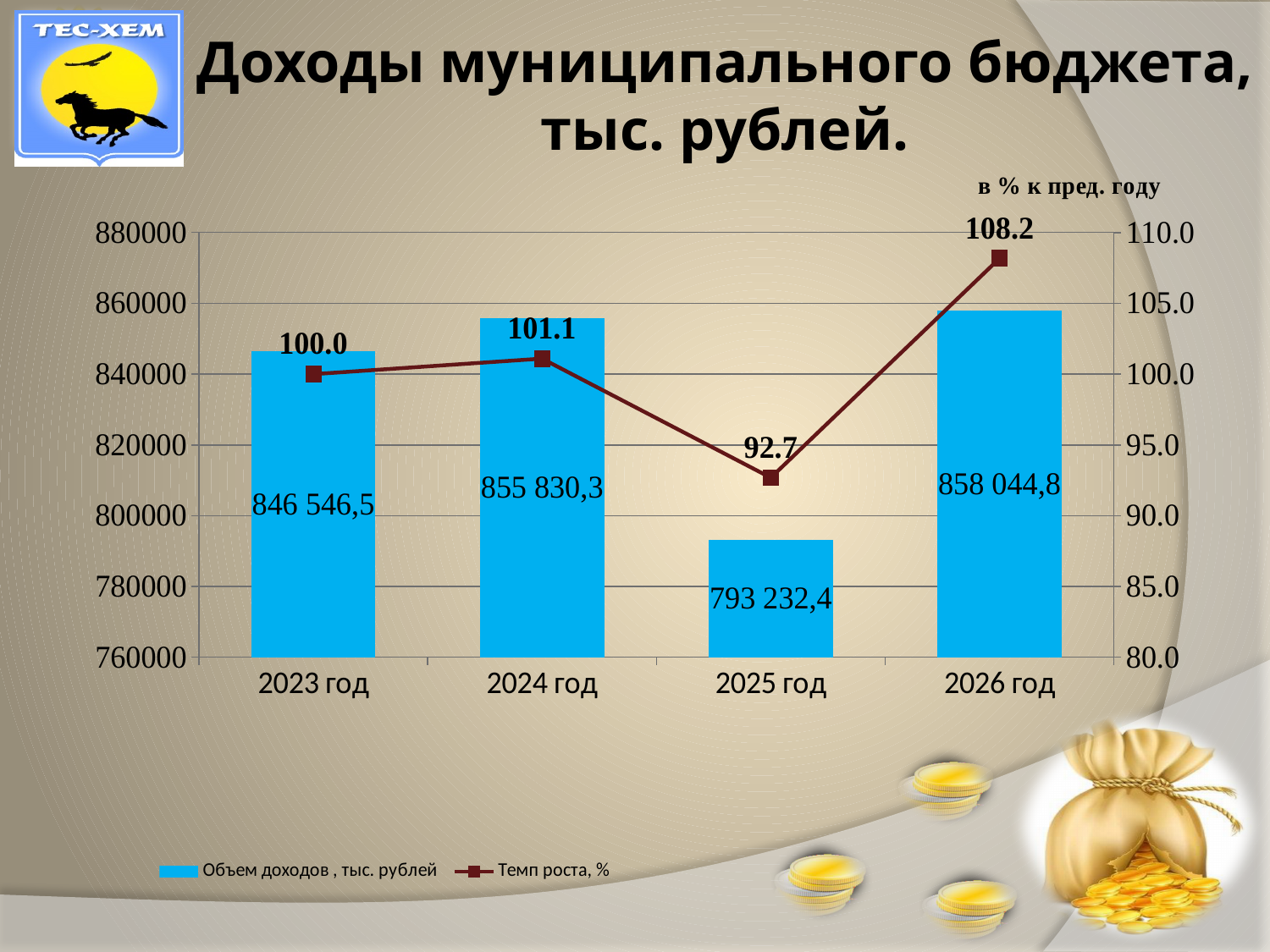
Which is larger, the Объем доходов for 2024 год or for 2023 год? 2024 год Which year has the highest Объем доходов? 2026 год What is the value of Объем доходов for 2023 год? 846 546,5 What is the difference in Объем доходов between 2026 год and 2024 год? 2 214,5 What is the title of the chart? Доходы муниципального бюджета, тыс. рублей. What kind of chart is this? Combined bar and line chart What is the Темп роста value for 2026 год? 108.2 Which year has the lowest Темп роста? 2025 год What is the value of Объем доходов for 2025 год? 793 232,4 How many series does the legend list? 2 What is the difference in Темп роста between 2026 год and 2025 год? 15.5 How many years are shown on the x axis? 4